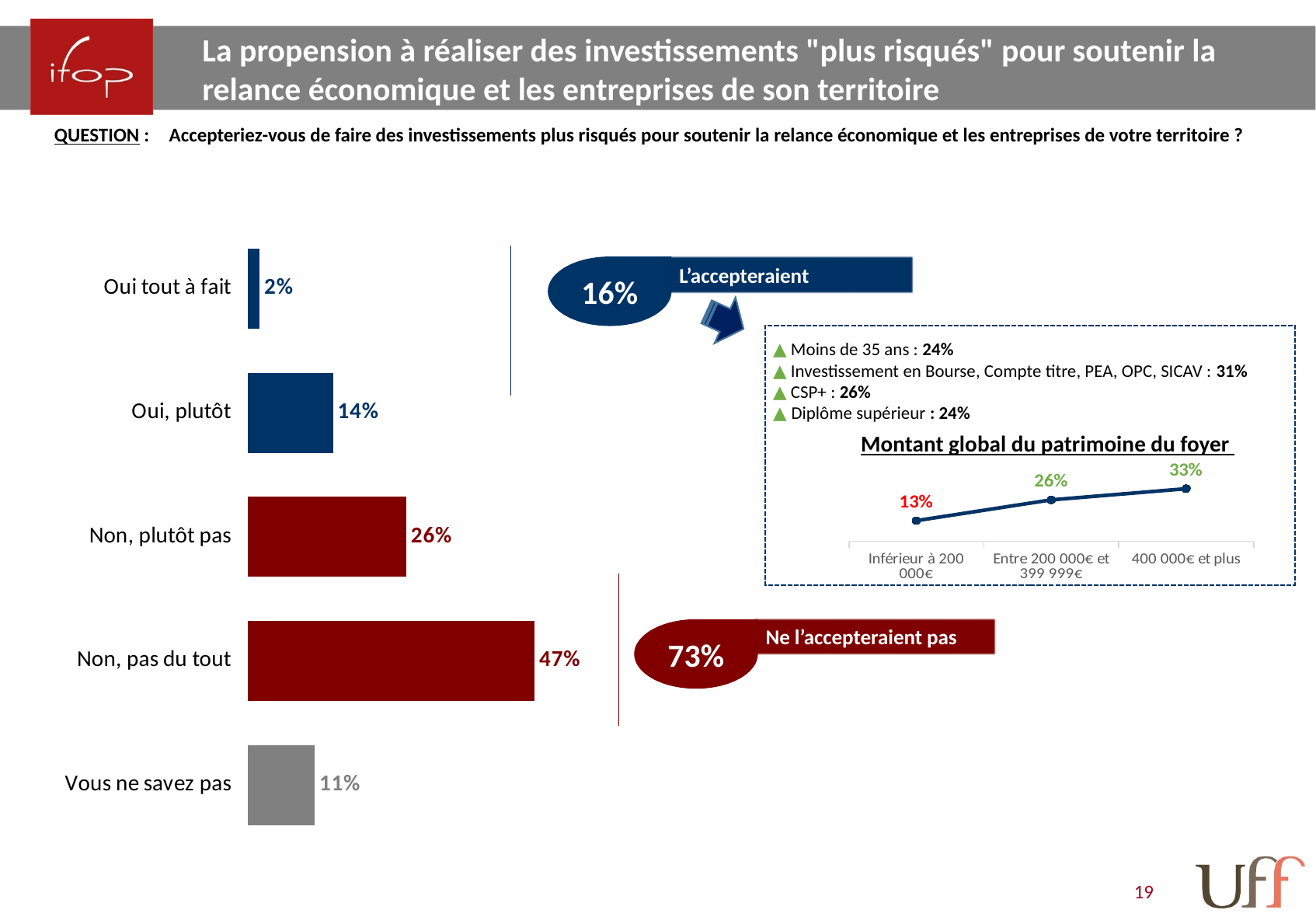
What kind of chart is the chart titled "Montant global du patrimoine du foyer"? Line chart In the bar chart on the left, what is the difference between "Non, pas du tout" and "Non, plutôt pas"? 21% In the bar chart on the left, what is the value for "Non, pas du tout"? 47% In the bar chart on the left, which category has the lowest value? Oui tout à fait In the bar chart on the left, what is the value for "Oui, plutôt"? 14% In the bar chart on the left, which category has the highest value? Non, pas du tout In the chart titled "Montant global du patrimoine du foyer", what is the value for "400 000€ et plus"? 33% How many categories does the bar chart on the left show? 5 What kind of chart is the chart on the left of the slide? Bar chart In the chart titled "Montant global du patrimoine du foyer", what is the value for "Inférieur à 200 000€"? 13% In the bar chart on the left, which is larger: "Non, plutôt pas" or "Vous ne savez pas"? Non, plutôt pas In the chart titled "Montant global du patrimoine du foyer", do the values rise or fall from left to right? Rise